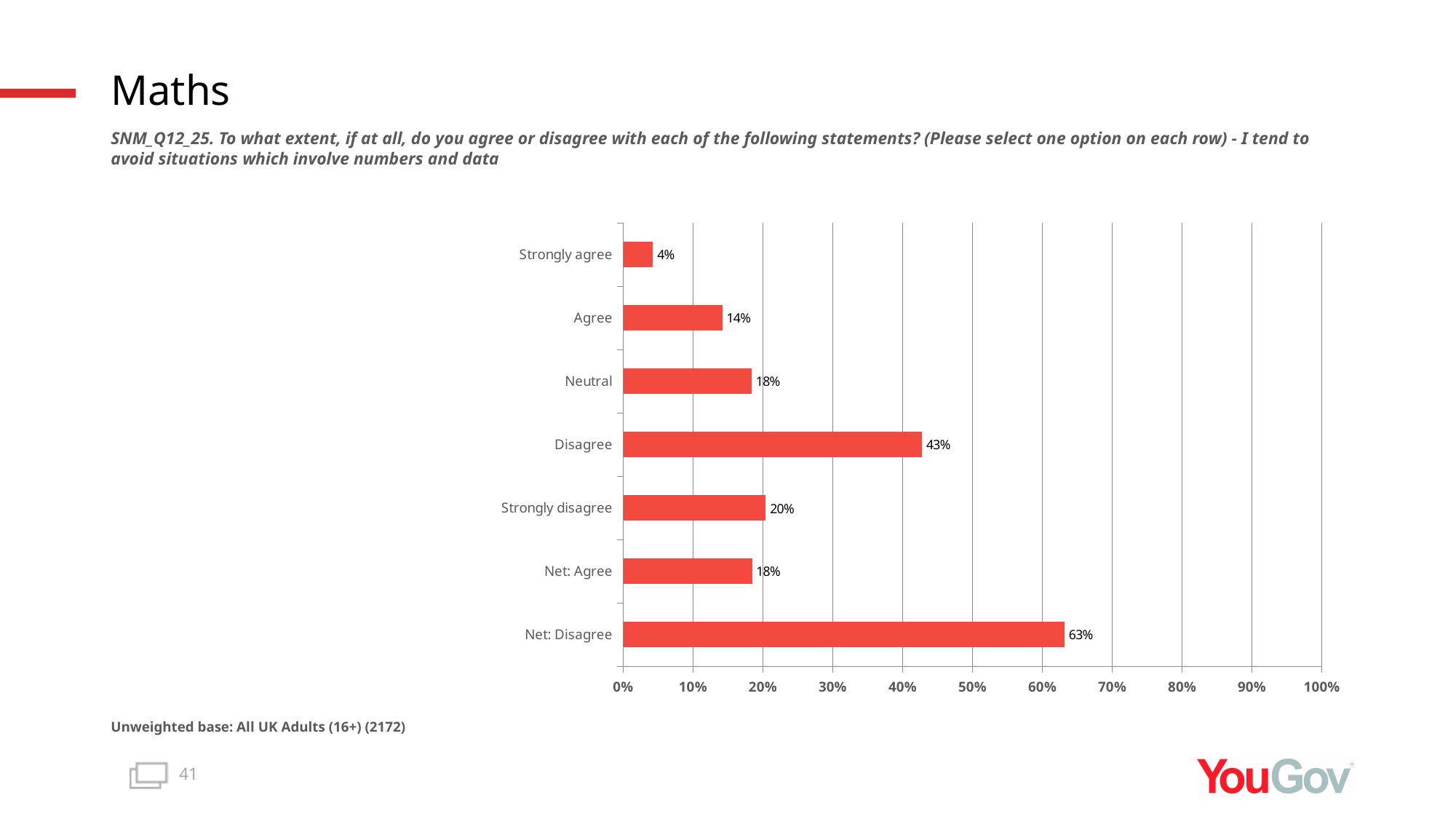
Is the value for 'Disagree' greater or less than 40%? greater What percentage of respondents selected 'Strongly agree'? 4% What is the difference between 'Net: Disagree' and 'Net: Agree'? 45% What percentage of respondents selected 'Strongly disagree'? 20% Which is larger, 'Agree' or 'Strongly disagree'? Strongly disagree How many categories are shown on the chart? 7 What is the value shown for 'Net: Disagree'? 63% What kind of chart is shown on the slide? Bar chart What is the difference between 'Disagree' and 'Strongly disagree'? 23% Which category has the lowest value? Strongly agree Which category has the highest value? Net: Disagree What is the value shown for 'Disagree'? 43%